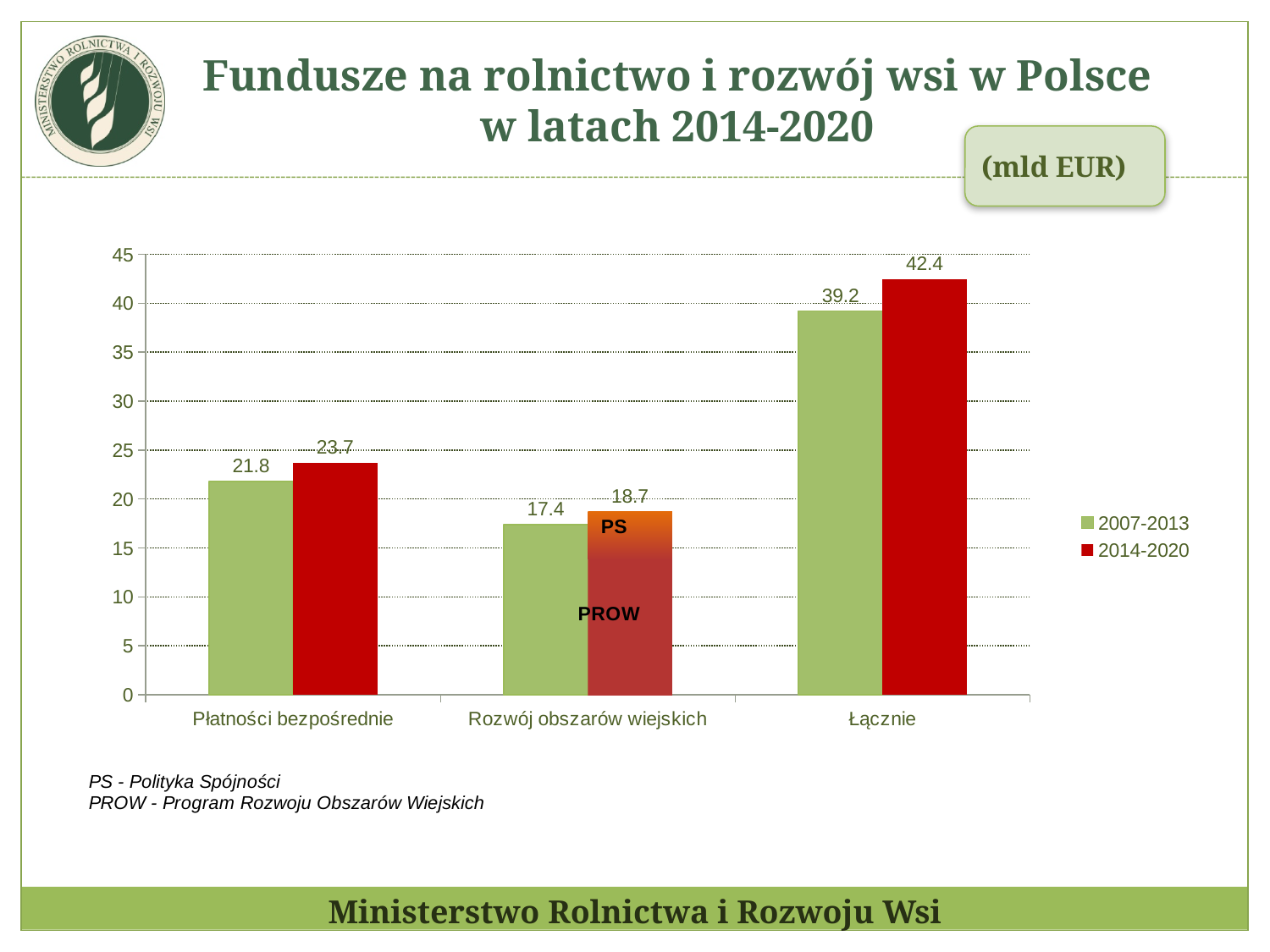
What is the value for Płatności bezpośrednie in the 2014-2020 series? 23.7 What is the value for Płatności bezpośrednie in the 2007-2013 series? 21.8 What is the difference between the 2014-2020 and 2007-2013 values for Łącznie? 3.2 Which category has the lowest value in the 2007-2013 series? Rozwój obszarów wiejskich How many categories are shown on the x axis? 3 What is the value for Łącznie in the 2007-2013 series? 39.2 What is the value for Rozwój obszarów wiejskich in the 2014-2020 series? 18.7 Is the 2007-2013 value for Łącznie greater or less than 40? less What kind of chart is shown on the slide? bar chart Which is larger for Rozwój obszarów wiejskich: the 2007-2013 value or the 2014-2020 value? 2014-2020 Which category has the highest value in the 2014-2020 series? Łącznie How many series does the legend list? 2